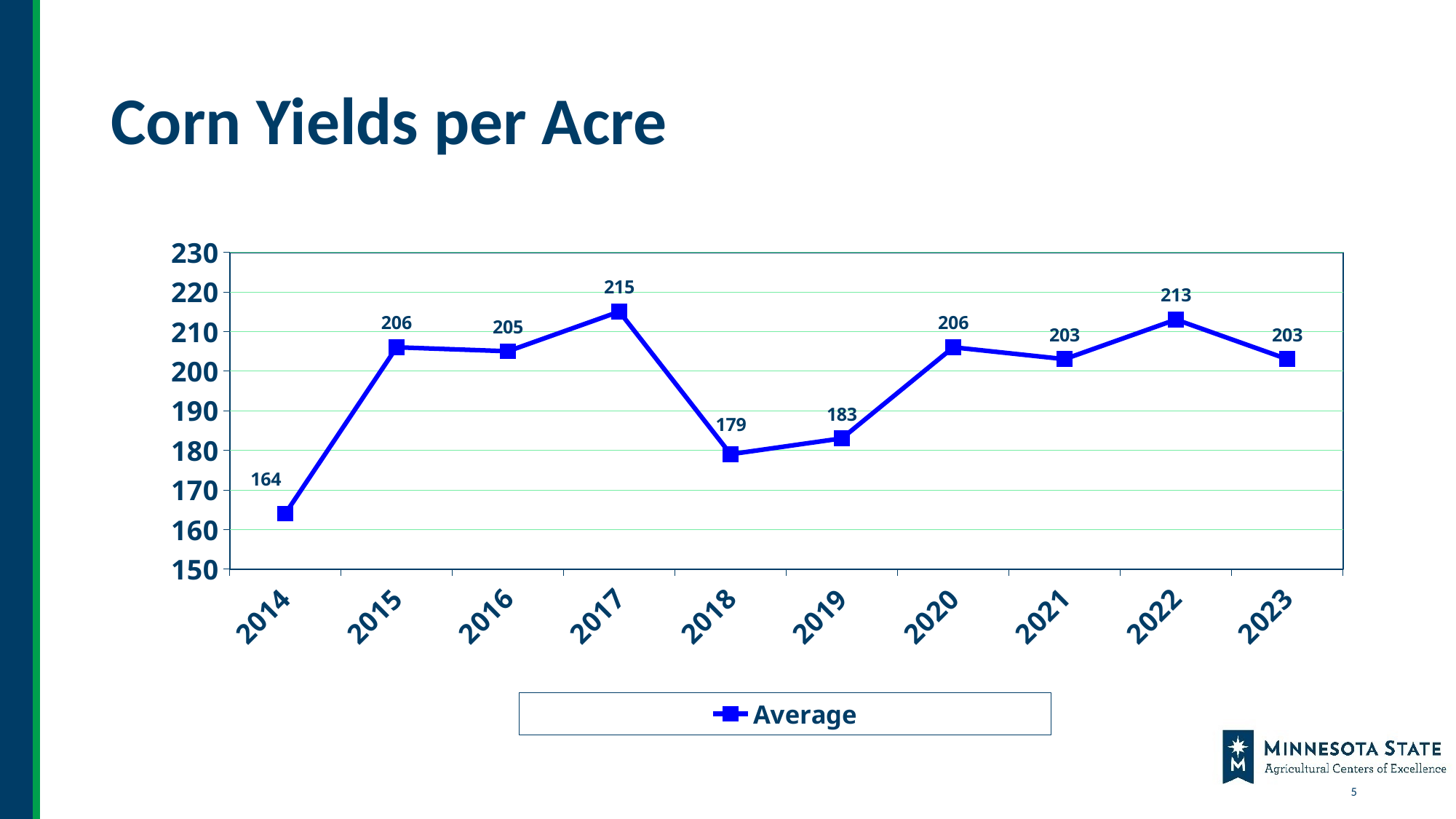
Which year has a higher corn yield, 2022 or 2023? 2022 Which year has the lowest average corn yield per acre? 2014 Is the corn yield for 2018 greater or less than 180? less How many series does the legend list? 1 Which year has the highest average corn yield per acre? 2017 What is the average corn yield per acre for 2019? 183 What is the average corn yield per acre for 2014? 164 What kind of chart is shown on the slide? line chart What is the average corn yield per acre for 2017? 215 What is the name of the series shown in the legend? Average How many years are plotted on the chart? 10 What is the difference between the corn yield in 2017 and the corn yield in 2018? 36